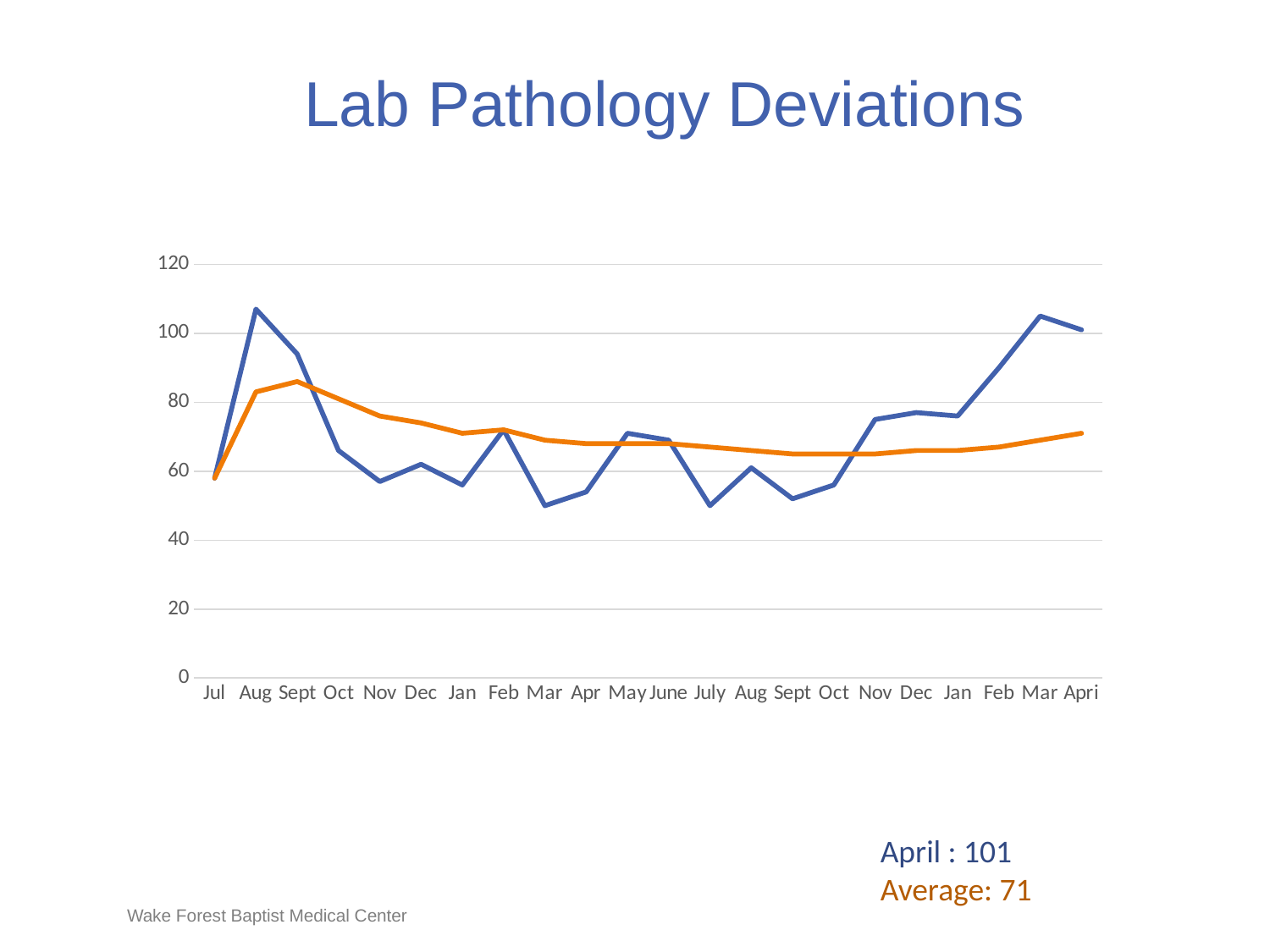
What is the average value shown for April? 71 Is the value of the blue line at the first Mar greater or less than 60? less What is the difference between the April value and the average? 30 What kind of chart is shown on the slide? line chart Which has the higher blue-line value, the first Aug or the first Oct? Aug Is the value of the blue line at the first Aug greater or less than 100? greater What is the value of the blue line at the final month, April? 101 What is the title of the chart? Lab Pathology Deviations Does the blue line rise or fall from the second Nov to the second Mar? rise Is the value of the orange line at the first Sept greater or less than 80? greater How many lines are plotted on the chart? 2 How many months are shown along the x axis? 22